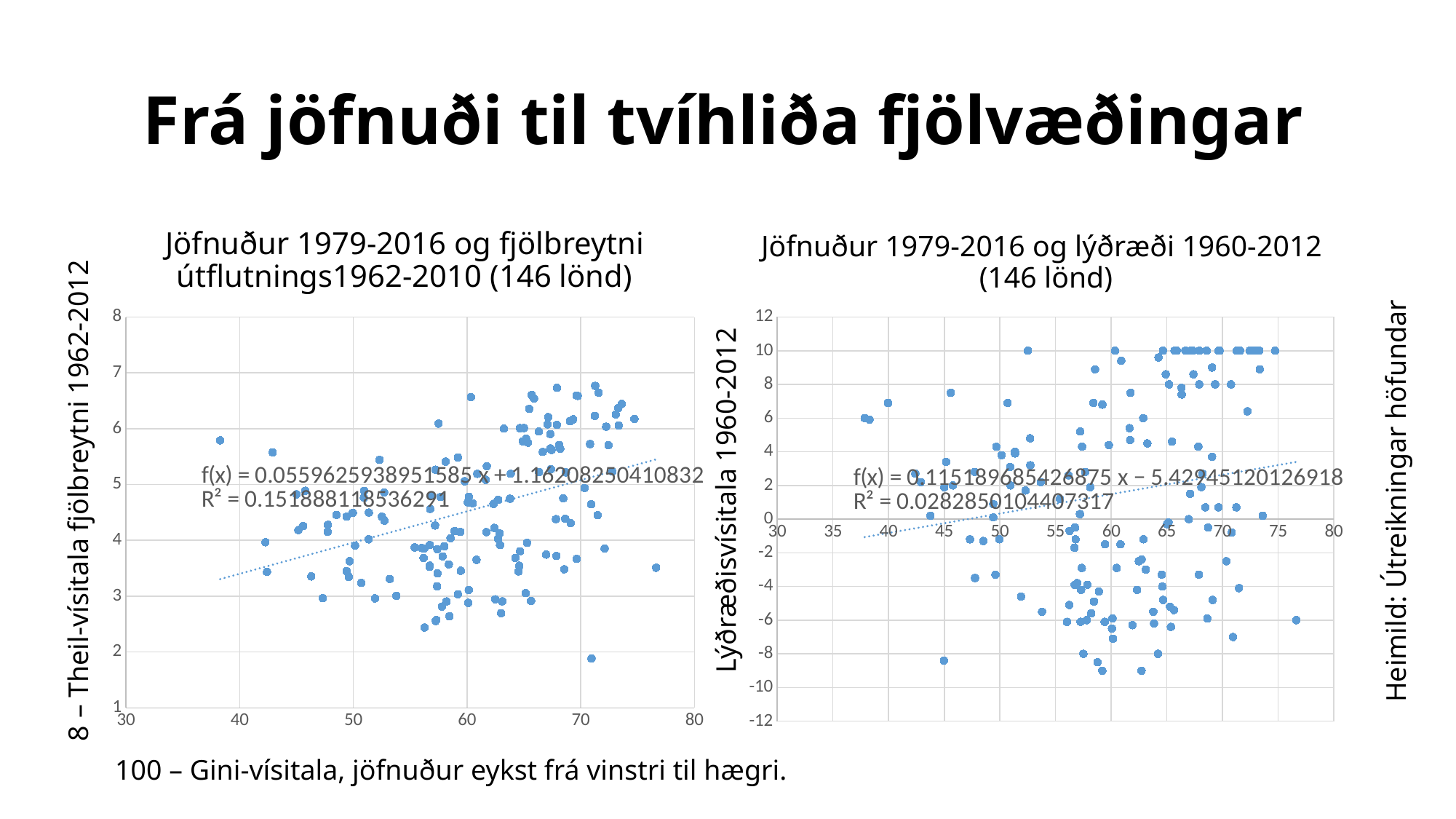
In the right chart, is the lowest plotted y value greater or less than -10? greater What is the y-axis label of the right chart? Lýðræðisvísitala 1960-2012 In the right chart, what is the R² value shown for the trendline? 0.0282850104407317 According to the chart titles, how many countries are included in each chart? 146 What kind of chart is the left chart, 'Jöfnuður 1979-2016 og fjölbreytni útflutnings 1962-2010'? Scatter chart In the left chart, does the fitted trendline rise or fall as the x value increases? Rises In the right chart, is the highest plotted y value greater or less than 8? greater In the left chart, what is the slope of the fitted line f(x)? 0.0559625938951585 Which chart has the higher R² value, the left chart or the right chart? The left chart In the left chart, what is the R² value shown for the trendline? 0.151888118536291 What kind of chart is the right chart, 'Jöfnuður 1979-2016 og lýðræði 1960-2012'? Scatter chart In the right chart, what is the intercept of the fitted line f(x)? -5.42945120126918